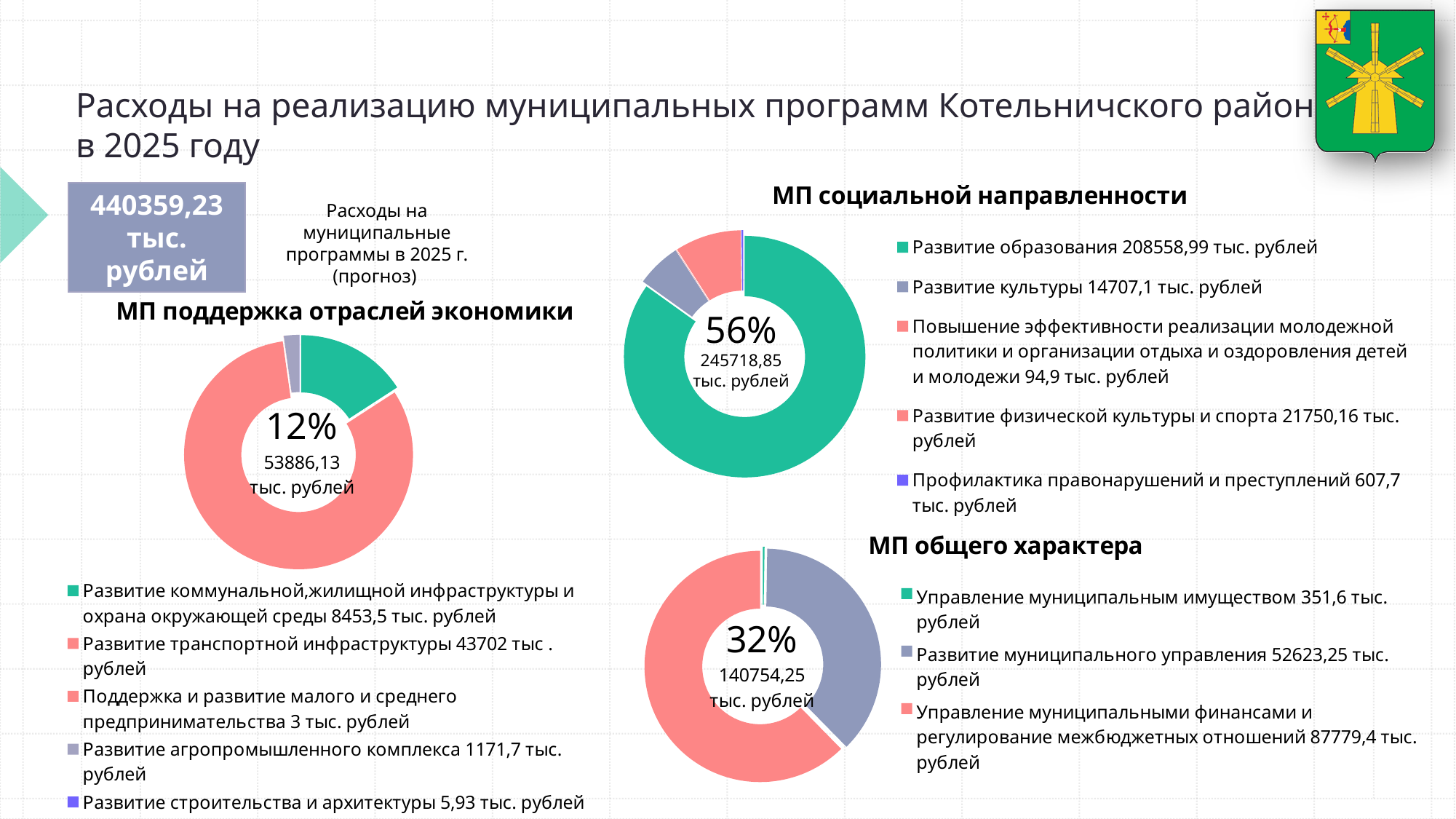
In the "МП поддержка отраслей экономики" chart, which is larger: "Развитие агропромышленного комплекса" or "Развитие строительства и архитектуры"? Развитие агропромышленного комплекса What share of total expenditure is shown in the centre of the "МП социальной направленности" chart? 56% What total amount is shown in the centre of the "МП общего характера" chart? 140754,25 тыс. рублей In the "МП общего характера" chart, what is the difference between "Управление муниципальными финансами и регулирование межбюджетных отношений" and "Развитие муниципального управления"? 35156,15 тыс. рублей What kind of chart is used for "МП поддержка отраслей экономики"? Pie (doughnut) chart In the "МП общего характера" chart, what is the value for "Развитие муниципального управления"? 52623,25 тыс. рублей How many categories does the legend of the "МП общего характера" chart list? 3 What total expenditure on municipal programmes in 2025 is shown in the box at the top left of the slide? 440359,23 тыс. рублей In the "МП поддержка отраслей экономики" chart, which category has the largest value? Развитие транспортной инфраструктуры In the "МП социальной направленности" chart, which category has the smallest value? Повышение эффективности реализации молодежной политики и организации отдыха и оздоровления детей и молодежи How many categories does the legend of the "МП социальной направленности" chart list? 5 In the "МП социальной направленности" chart, what is the value for "Развитие образования"? 208558,99 тыс. рублей